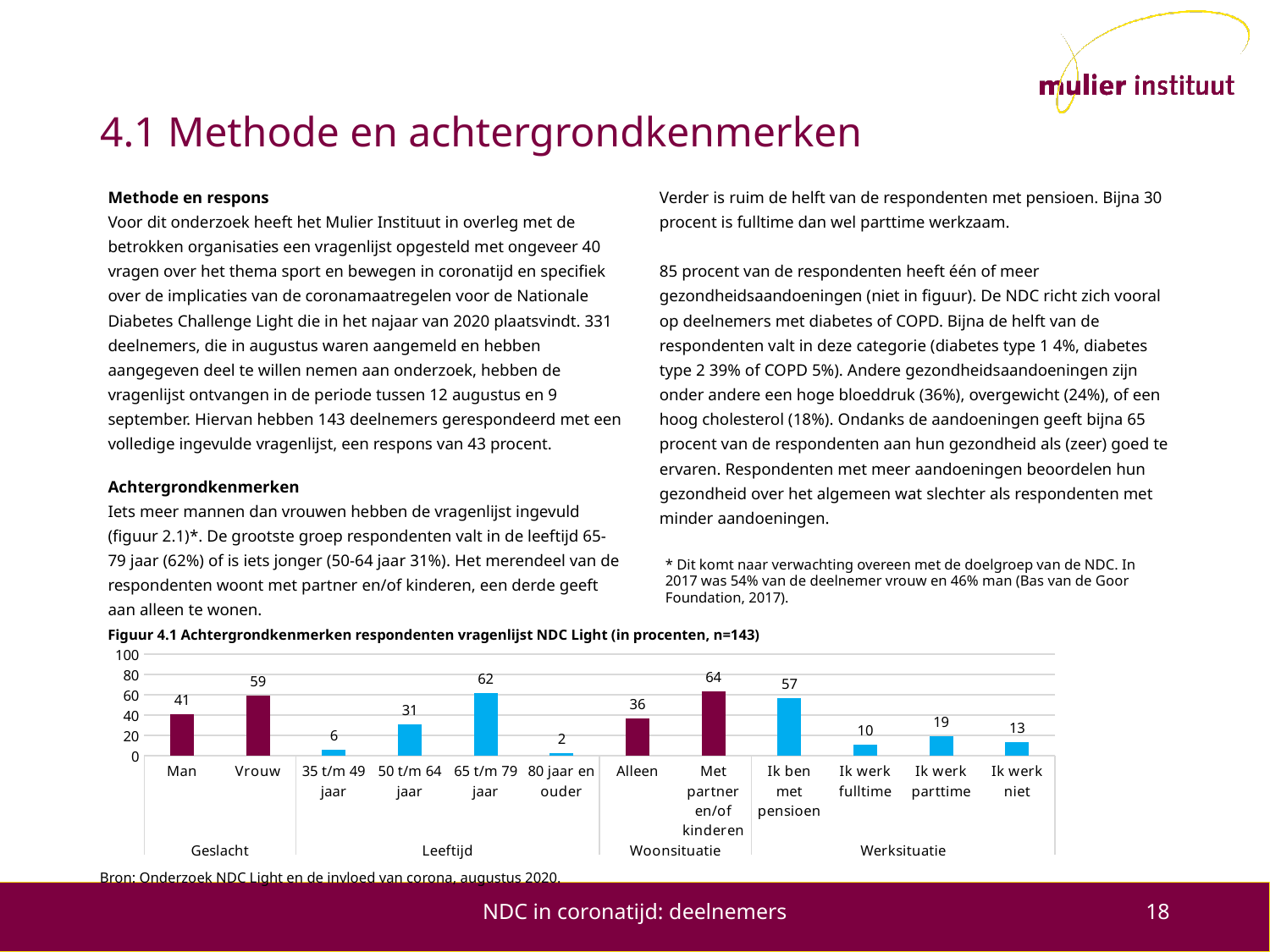
Which category has the highest value in the chart? Met partner en/of kinderen Which category has the lowest value in the chart? 80 jaar en ouder What kind of chart is shown on the slide? bar chart What is the title of the figure on the slide? Figuur 4.1 Achtergrondkenmerken respondenten vragenlijst NDC Light (in procenten, n=143) What is the difference between the values for Ik ben met pensioen and Ik werk fulltime? 47 Which is larger, the value for Alleen or the value for 50 t/m 64 jaar? Alleen What is the value for Vrouw in the chart? 59 What is the difference between the values for Vrouw and Man? 18 What is the value for Ik werk parttime in the chart? 19 Is the value for Ik ben met pensioen greater or less than 40? greater What is the value for 65 t/m 79 jaar in the chart? 62 How many categories (bars) are shown in the chart? 12